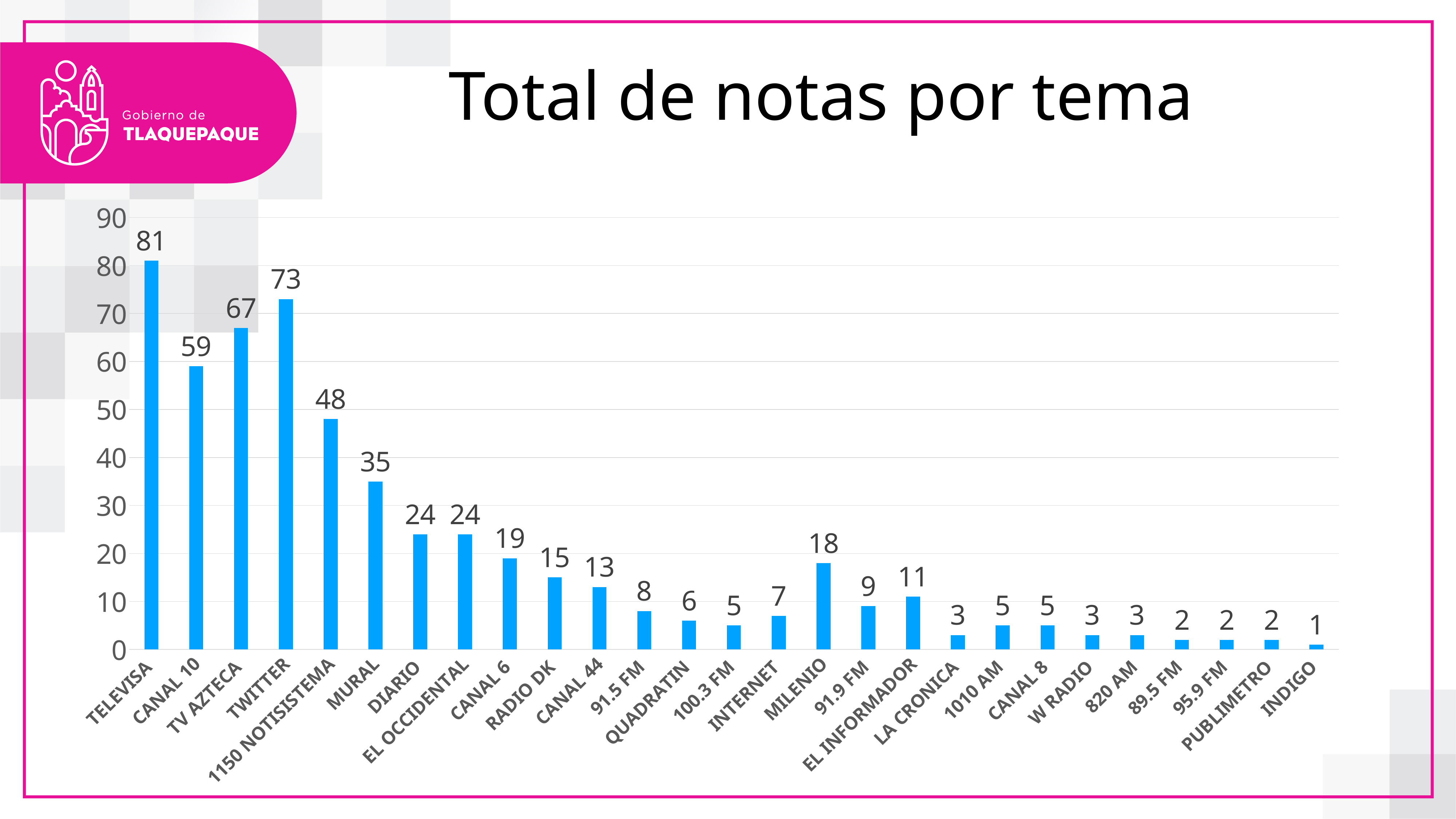
Which is larger, the value for MURAL or the value for 1150 NOTISISTEMA? 1150 NOTISISTEMA Which category has the lowest value? INDIGO What is the value for TWITTER? 73 What is the difference between the values for TWITTER and TV AZTECA? 6 What is the title of the chart? Total de notas por tema What is the value for TELEVISA? 81 What is the difference between the values for TELEVISA and CANAL 10? 22 Which category has the highest value? TELEVISA What is the value for EL INFORMADOR? 11 What is the value for MILENIO? 18 What kind of chart is shown on the slide? bar chart How many categories are shown on the x axis? 27